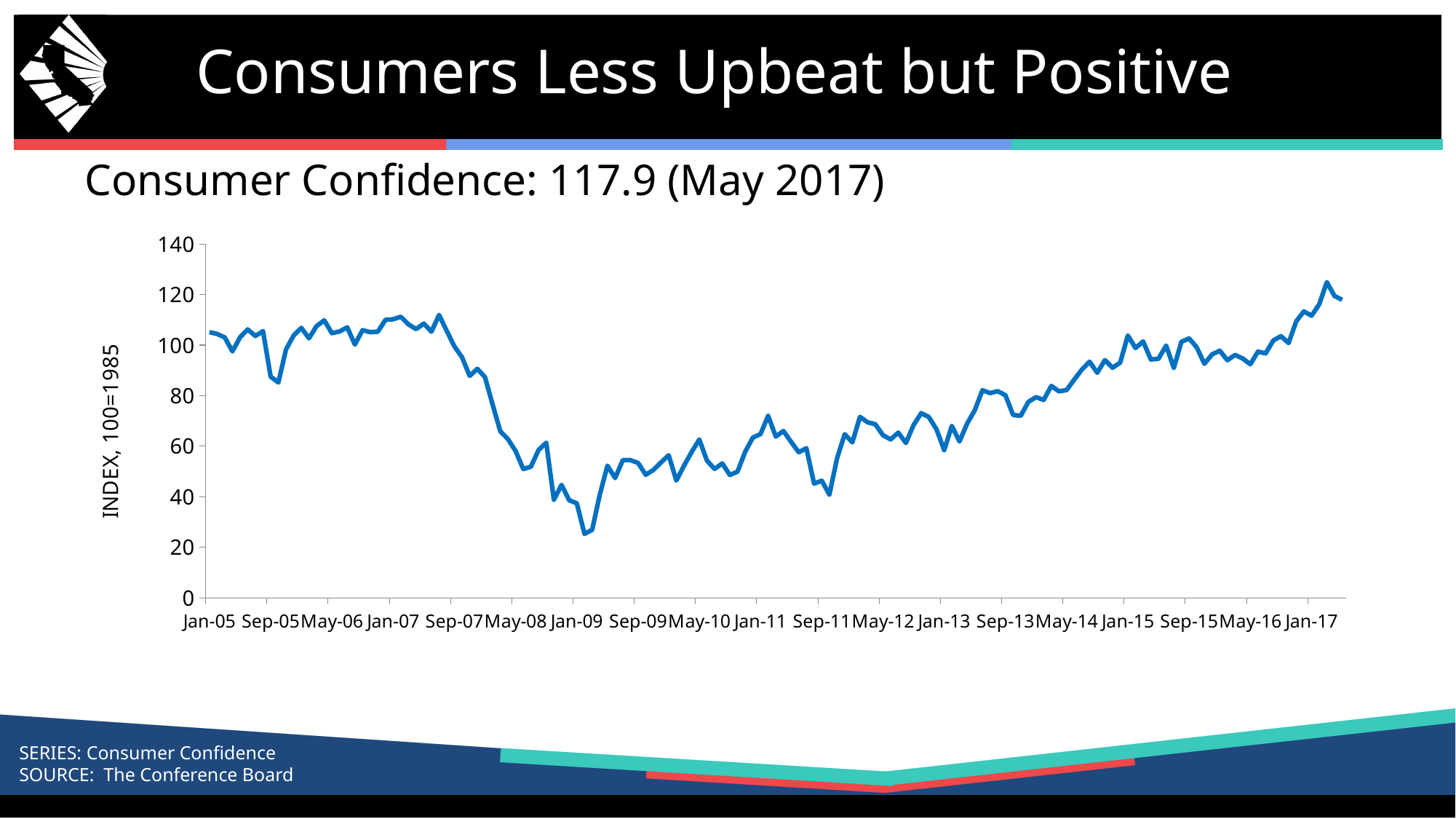
Does the line rise or fall between Sep-07 and Jan-09? fall What is the Consumer Confidence value for May 2017 stated on the slide? 117.9 What is the label on the vertical axis? INDEX, 100=1985 What source is cited for the chart data? The Conference Board What kind of chart is shown on the slide? line chart Is the value for Jan-07 greater or less than 100? greater Is the value for Sep-11 greater or less than 80? less Which is larger, the value at Jan-05 or the value at Jan-09? Jan-05 Is the value for Jan-17 greater or less than 100? greater In which year does the line reach its lowest point? 2009 Does the line rise or fall between Jan-13 and Jan-17? rise